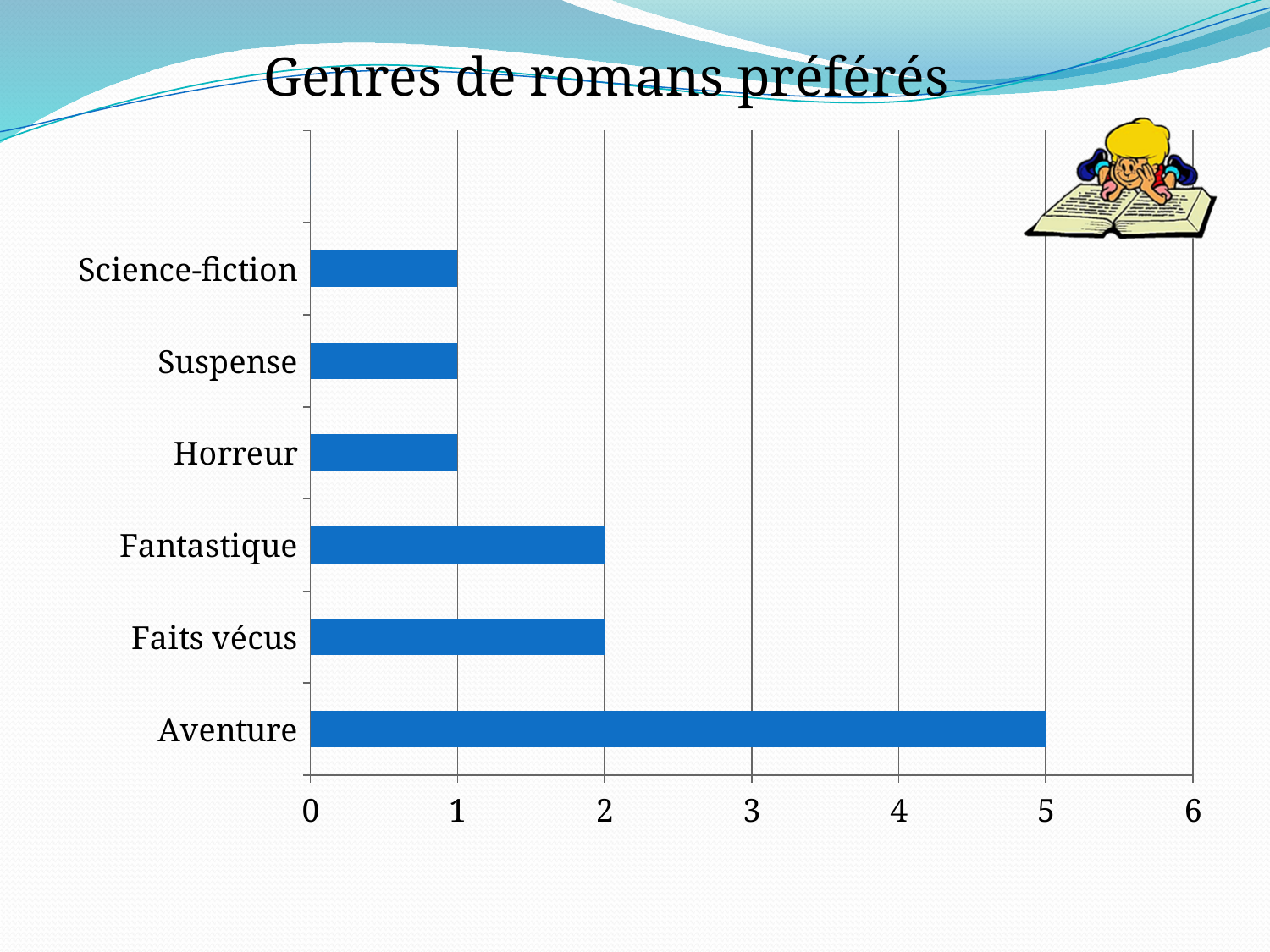
What is the difference between the values for Faits vécus and Suspense? 1 What is the value for Horreur? 1 Which category has the highest value? Aventure What is the title of the chart? Genres de romans préférés How many categories are shown in the chart? 6 Is the value for Aventure greater or less than 4? greater What kind of chart is shown on the slide? Bar chart What is the value for Faits vécus? 2 What is the value for Fantastique? 2 Which is larger, the value for Fantastique or the value for Science-fiction? Fantastique What is the difference between the values for Aventure and Fantastique? 3 What is the value for Aventure? 5